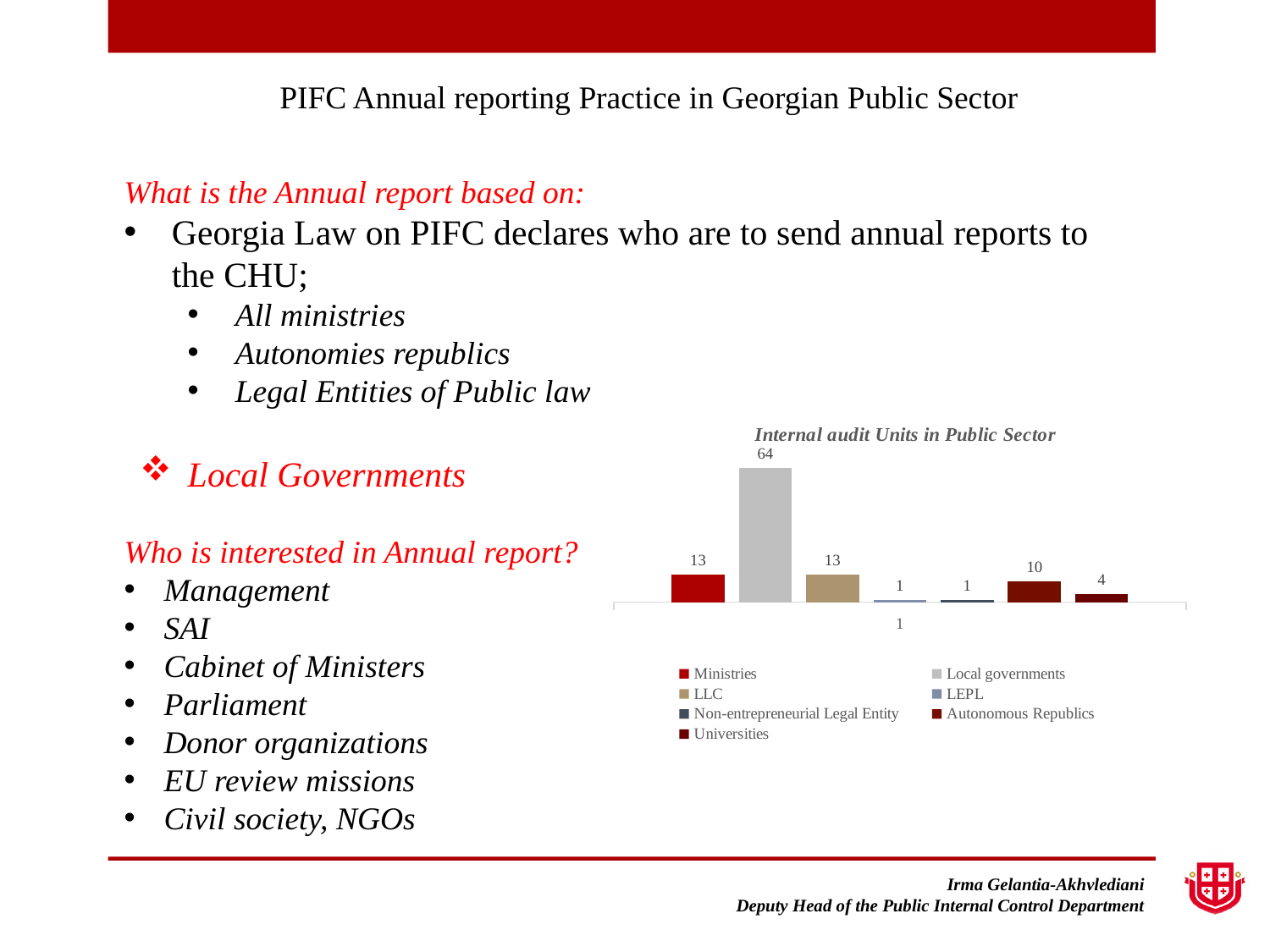
What is the value for Local governments in the chart? 64 What is the difference between the values for Local governments and Ministries? 51 What kind of chart is shown on the slide? bar chart How many series does the chart legend list? 7 What is the value for Universities in the chart? 4 What is the title of the chart on the slide? Internal audit Units in Public Sector What is the value for LEPL in the chart? 1 Which series has the highest value in the chart? Local governments What is the difference between the values for LLC and Universities? 9 What is the value for Autonomous Republics in the chart? 10 Which is larger, the value for Autonomous Republics or the value for Universities? Autonomous Republics What is the value for Ministries in the chart? 13